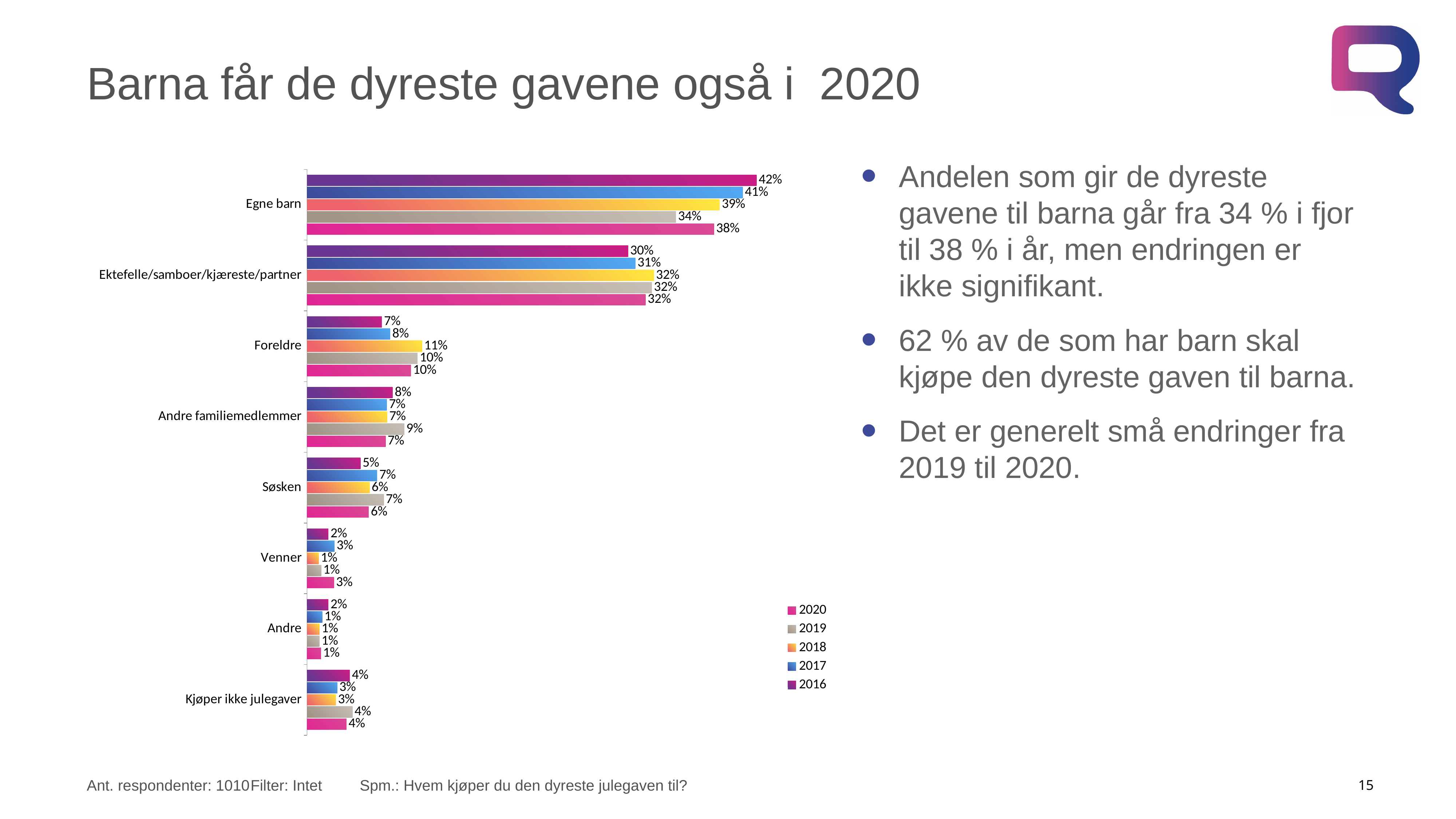
Which category has the lowest 2020 value? Andre What is the 2016 value for Ektefelle/samboer/kjæreste/partner? 30% What is the 2019 value for Egne barn? 34% How many series does the legend list? 5 Which is larger for Søsken: the 2017 value or the 2016 value? 2017 What is the difference between the 2020 and 2019 values for Egne barn? 4% What is the 2020 value for Egne barn? 38% Which category has the highest 2020 value? Egne barn What kind of chart is shown on the slide? bar chart How many categories are shown on the chart? 8 What is the 2018 value for Foreldre? 11% Which series is shown in pink in the legend? 2020